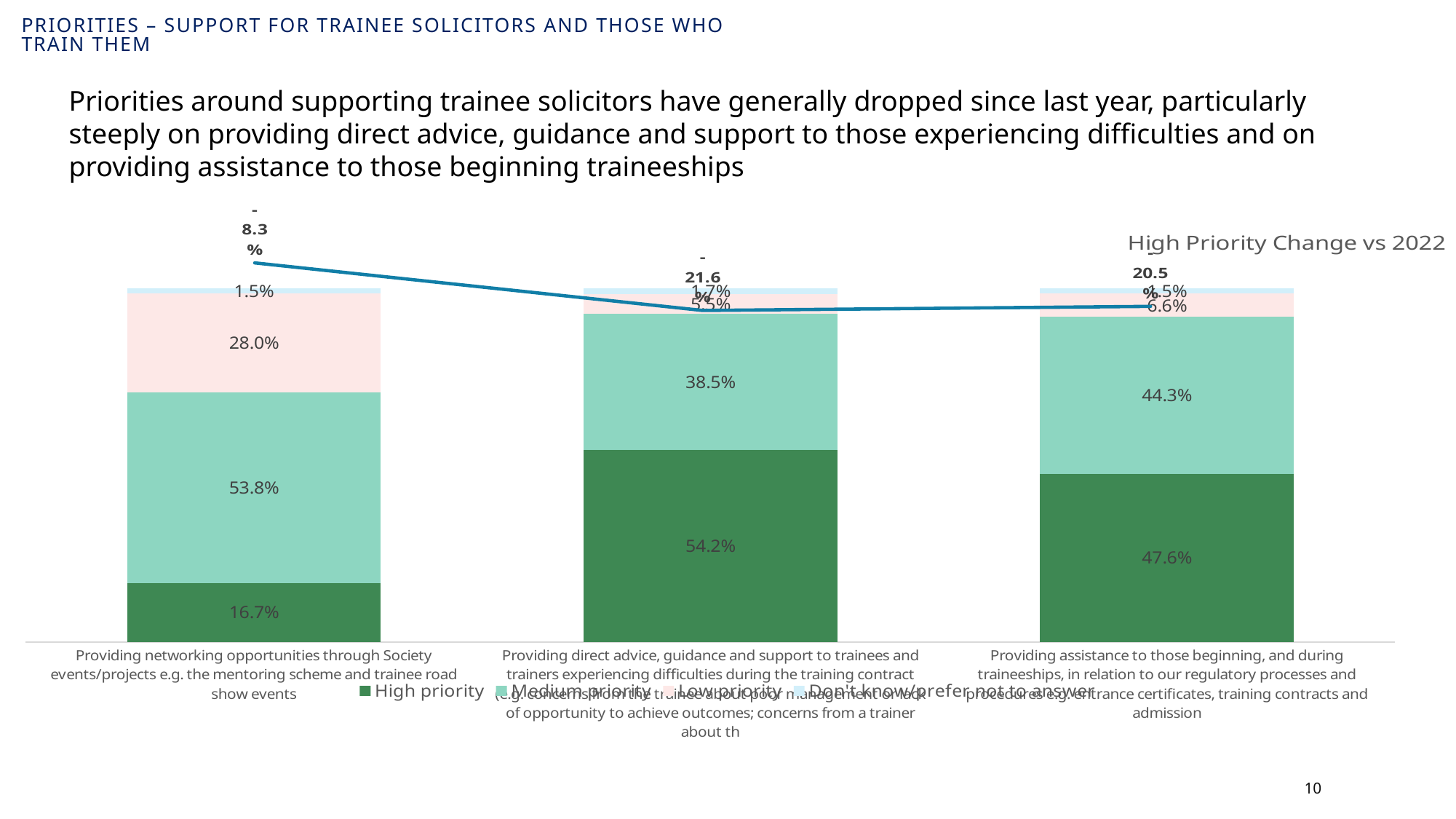
What is the High priority value for 'Providing assistance to those beginning, and during traineeships'? 47.6% What is the Medium priority value for 'Providing direct advice, guidance and support to trainees and trainers experiencing difficulties'? 38.5% What is the difference in High priority percentage between 'Providing direct advice, guidance and support' and 'Providing assistance to those beginning, and during traineeships'? 6.6 percentage points Which category has the highest High priority percentage? Providing direct advice, guidance and support to trainees and trainers experiencing difficulties What percentage rated 'Providing networking opportunities through Society events/projects' as High priority? 16.7% What is the Low priority value for 'Providing networking opportunities through Society events/projects'? 28.0% Which category has the lowest High priority percentage? Providing networking opportunities through Society events/projects How many series does the chart legend list? 4 How many categories are shown on the x axis of the chart? 3 Which has a larger Medium priority share: 'Providing networking opportunities' or 'Providing assistance to those beginning, and during traineeships'? Providing networking opportunities What kind of chart is used to show the priority ratings? Stacked bar chart What is the 'High Priority Change vs 2022' value shown for 'Providing networking opportunities through Society events/projects'? -8.3%